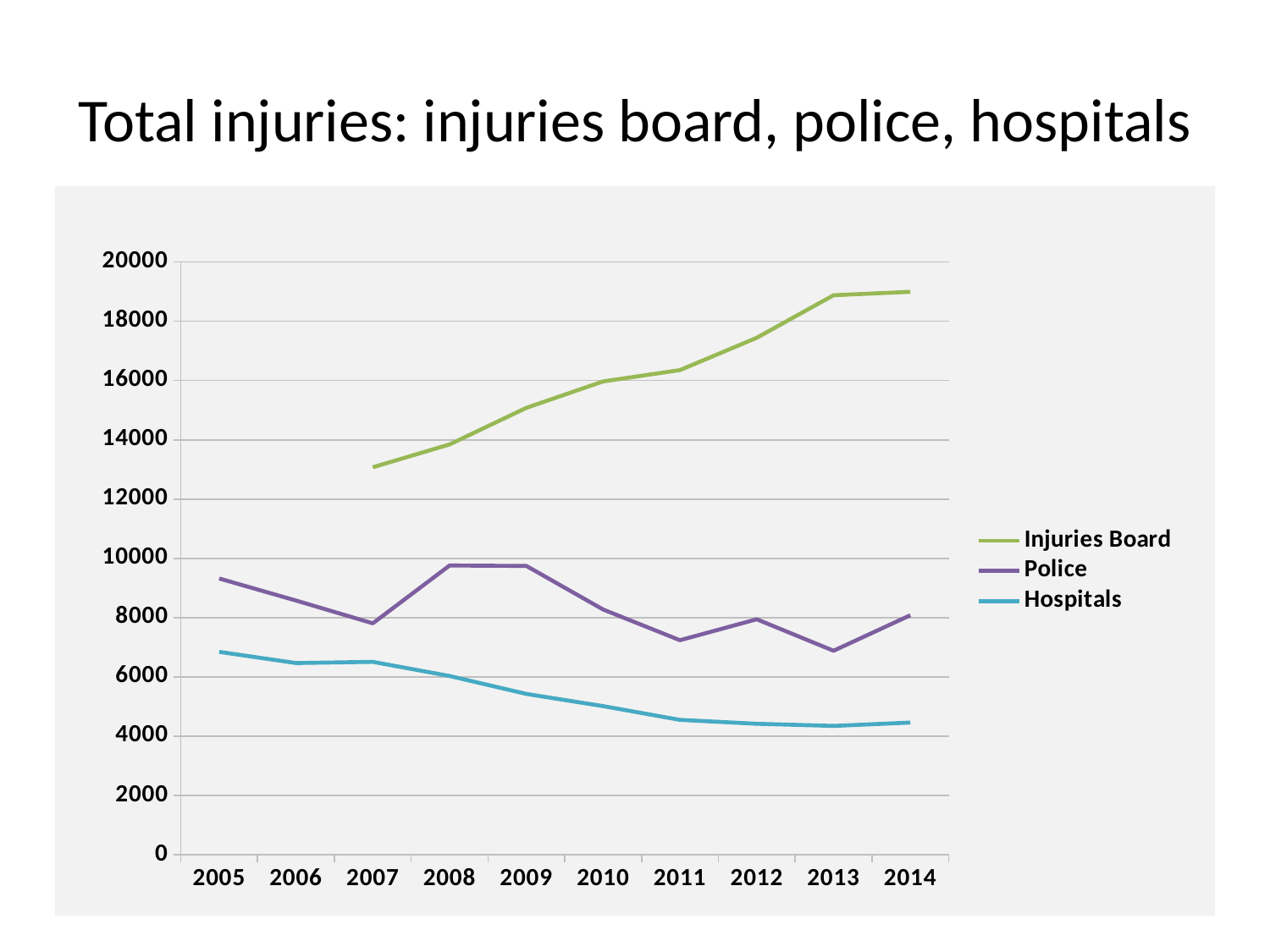
Is the Police value for 2013 greater or less than 8000? less Does the Hospitals line rise or fall from 2005 to 2013? fall Which series has the highest value in 2014? Injuries Board Which series has the lowest value in 2012? Hospitals How many series does the legend list? 3 Is the Hospitals value for 2005 greater or less than 6000? greater Is the Injuries Board value for 2014 greater or less than 18000? greater How many years are shown on the x axis? 10 What kind of chart is shown on the slide? line chart In 2010, which is larger: the Police value or the Hospitals value? Police Does the Injuries Board line rise or fall from 2007 to 2014? rise